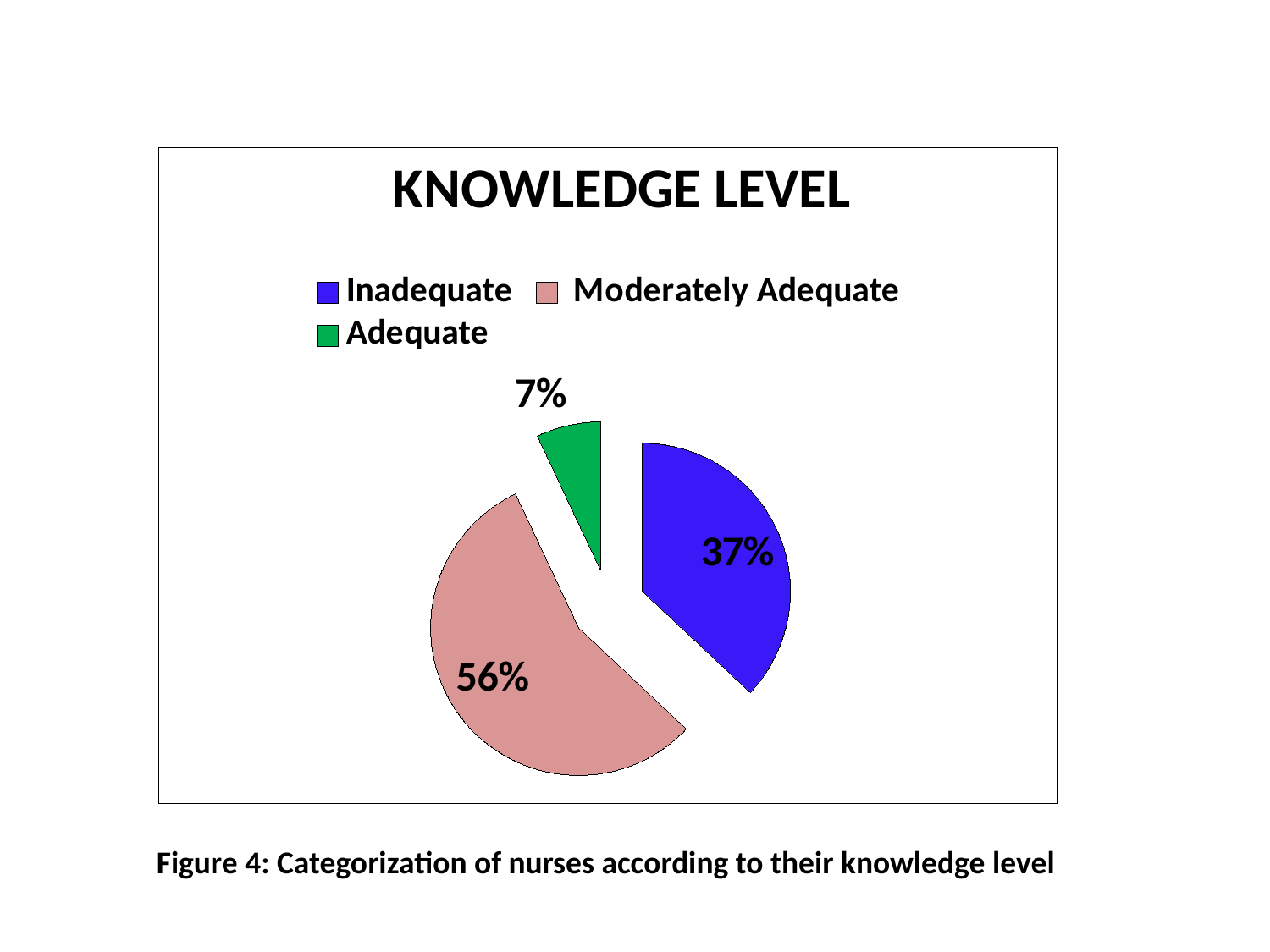
What is the difference in percentage points between the Moderately Adequate and Inadequate slices? 19 What percentage of nurses have an Inadequate knowledge level? 37% What kind of chart is shown on the slide? Pie chart Which knowledge level category has the largest share of the pie? Moderately Adequate What is the combined percentage of the Inadequate and Adequate slices? 44% How many categories are shown in the pie chart? 3 Which knowledge level category has the smallest share of the pie? Adequate What percentage of nurses have an Adequate knowledge level? 7% Which is larger, the Inadequate slice or the Adequate slice? Inadequate What percentage of nurses have a Moderately Adequate knowledge level? 56% What is the title of the chart? KNOWLEDGE LEVEL Which colour represents the Adequate category in the pie chart? Green